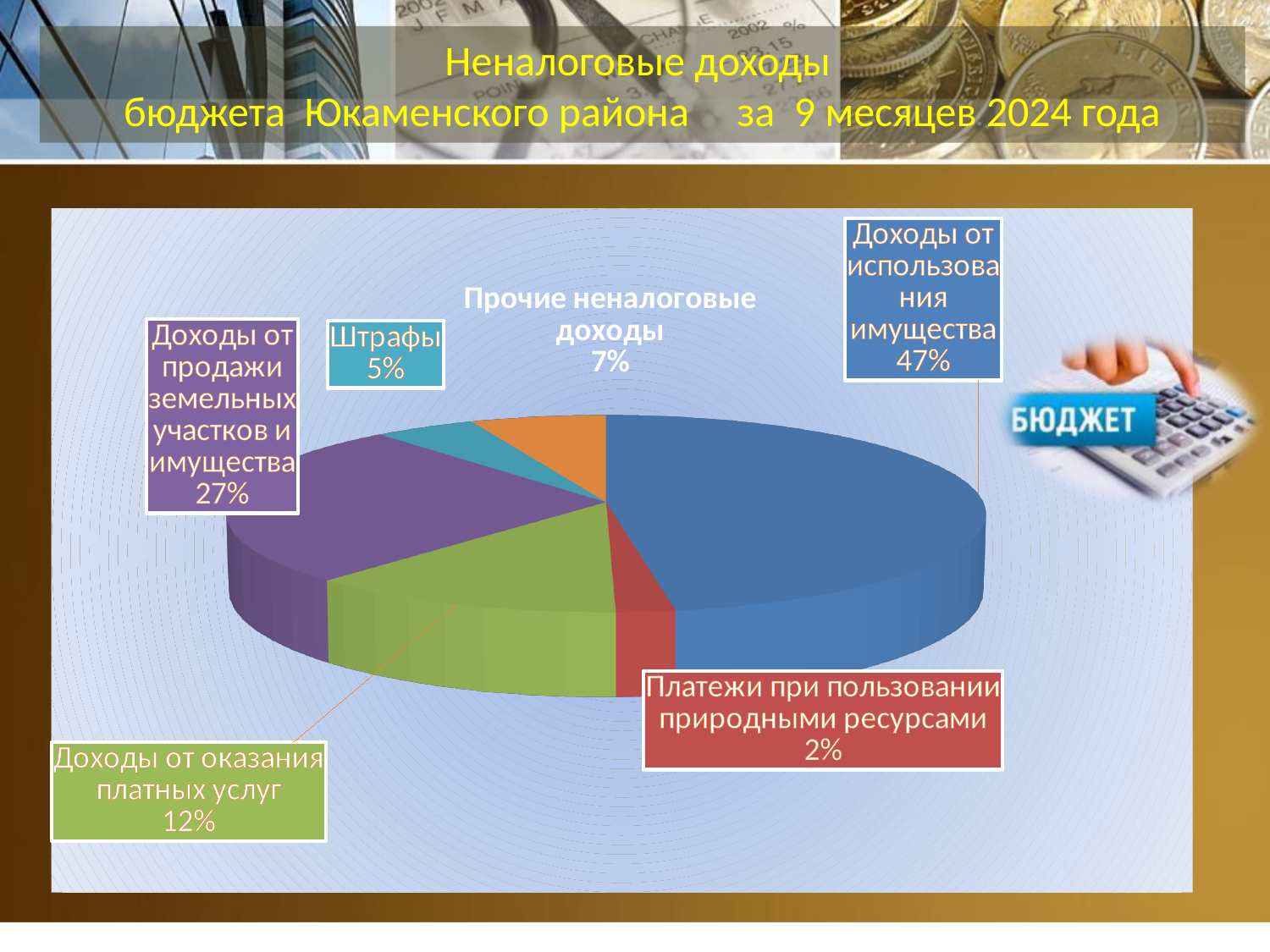
What is the difference in percentage points between "Доходы от использования имущества" and "Доходы от продажи земельных участков и имущества"? 20 What percentage is labelled for "Платежи при пользовании природными ресурсами"? 2% Which is larger: the share for "Доходы от оказания платных услуг" or the share for "Прочие неналоговые доходы"? Доходы от оказания платных услуг What share of non-tax revenues comes from "Доходы от использования имущества"? 47% What is the combined share of "Штрафы" and "Прочие неналоговые доходы"? 12% What type of chart is shown on the slide? Pie chart How many categories are shown in the pie chart? 6 Which category has the largest slice of the pie chart? Доходы от использования имущества What percentage is shown for "Доходы от продажи земельных участков и имущества"? 27% What colour is the slice for "Доходы от оказания платных услуг"? Green Which category has the smallest slice of the pie chart? Платежи при пользовании природными ресурсами What share does "Штрафы" account for in the pie chart? 5%